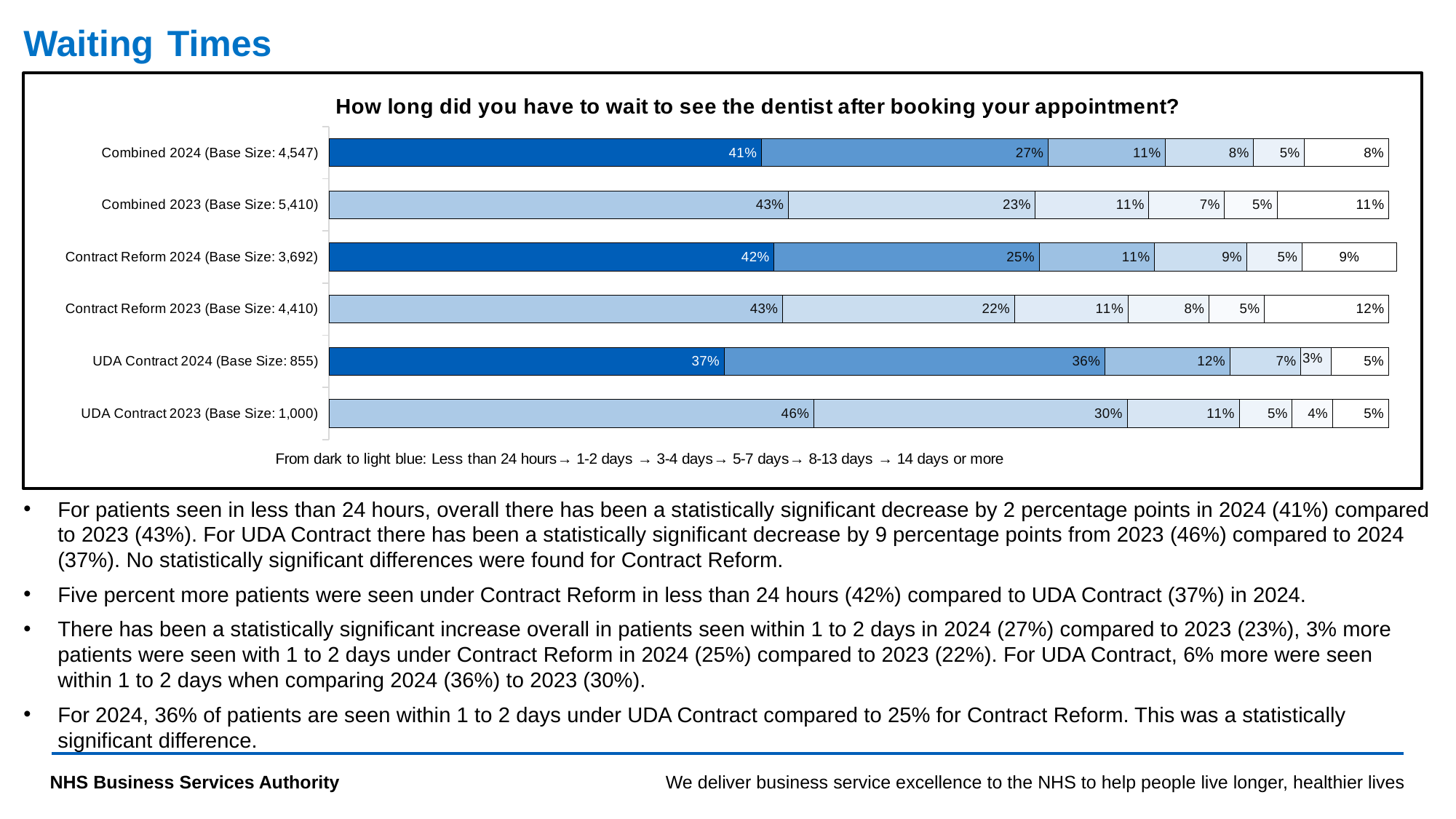
What type of chart is shown on the slide? Stacked horizontal bar chart Which has a larger 1-2 days percentage: UDA Contract 2024 or Contract Reform 2024? UDA Contract 2024 What is the title of the chart? How long did you have to wait to see the dentist after booking your appointment? What is the 8-13 days value for UDA Contract 2024? 3% What percentage of Combined 2024 respondents waited less than 24 hours to see the dentist? 41% What is the difference in the less than 24 hours percentage between Combined 2023 and Combined 2024? 2 percentage points What is the value for 1-2 days for UDA Contract 2024? 36% How many groups (bars) are shown in the chart? 6 How many waiting-time bands make up each stacked bar? 6 Which group has the highest percentage of patients seen in less than 24 hours? UDA Contract 2023 (Base Size: 1,000) What percentage of Contract Reform 2023 respondents waited 14 days or more? 12% Which group has the lowest percentage of patients seen in less than 24 hours? UDA Contract 2024 (Base Size: 855)